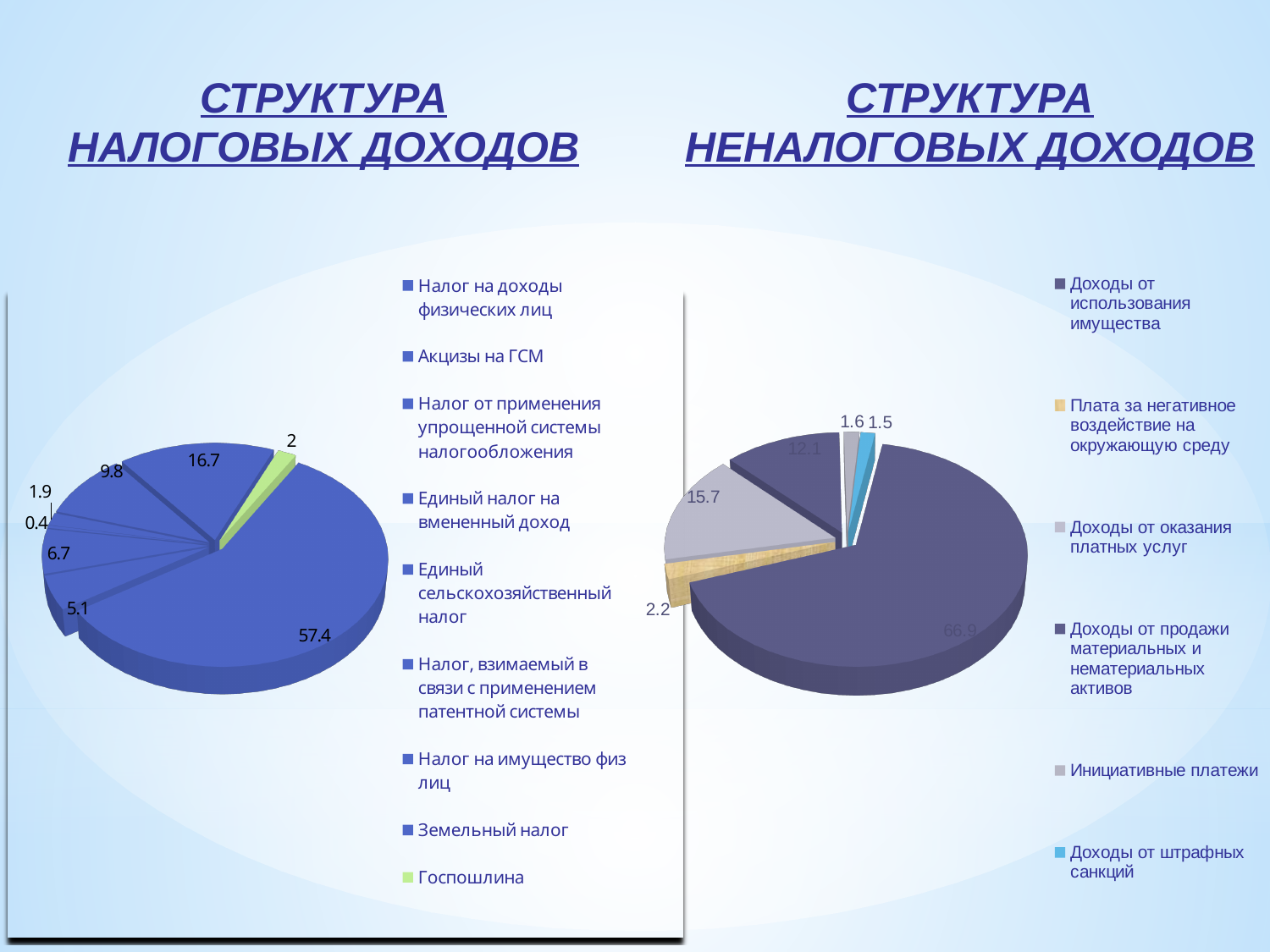
In the 'СТРУКТУРА НЕНАЛОГОВЫХ ДОХОДОВ' chart, what is the value of the 'Плата за негативное воздействие на окружающую среду' slice? 2.2 In the 'СТРУКТУРА НЕНАЛОГОВЫХ ДОХОДОВ' chart, what is the value of the largest slice? 66.9 In the 'СТРУКТУРА НАЛОГОВЫХ ДОХОДОВ' chart, what is the difference between the slices labelled 16.7 and 9.8? 6.9 In the 'СТРУКТУРА НЕНАЛОГОВЫХ ДОХОДОВ' chart, what is the difference between the slices labelled 15.7 and 12.1? 3.6 In the 'СТРУКТУРА НАЛОГОВЫХ ДОХОДОВ' chart, what is the value of the smallest slice? 0.4 What kind of chart is shown under the title 'СТРУКТУРА НАЛОГОВЫХ ДОХОДОВ'? Pie chart In the 'СТРУКТУРА НЕНАЛОГОВЫХ ДОХОДОВ' chart, what is the value of the 'Доходы от штрафных санкций' slice? 1.5 How many slices does the 'СТРУКТУРА НЕНАЛОГОВЫХ ДОХОДОВ' pie chart have? 6 In the 'СТРУКТУРА НЕНАЛОГОВЫХ ДОХОДОВ' chart, which is larger: the slice labelled 15.7 or the slice labelled 12.1? 15.7 In the 'СТРУКТУРА НАЛОГОВЫХ ДОХОДОВ' chart, what is the value of the largest slice? 57.4 How many entries does the legend of the 'СТРУКТУРА НАЛОГОВЫХ ДОХОДОВ' chart list? 9 In the 'СТРУКТУРА НАЛОГОВЫХ ДОХОДОВ' chart, what is the value of the green 'Госпошлина' slice? 2